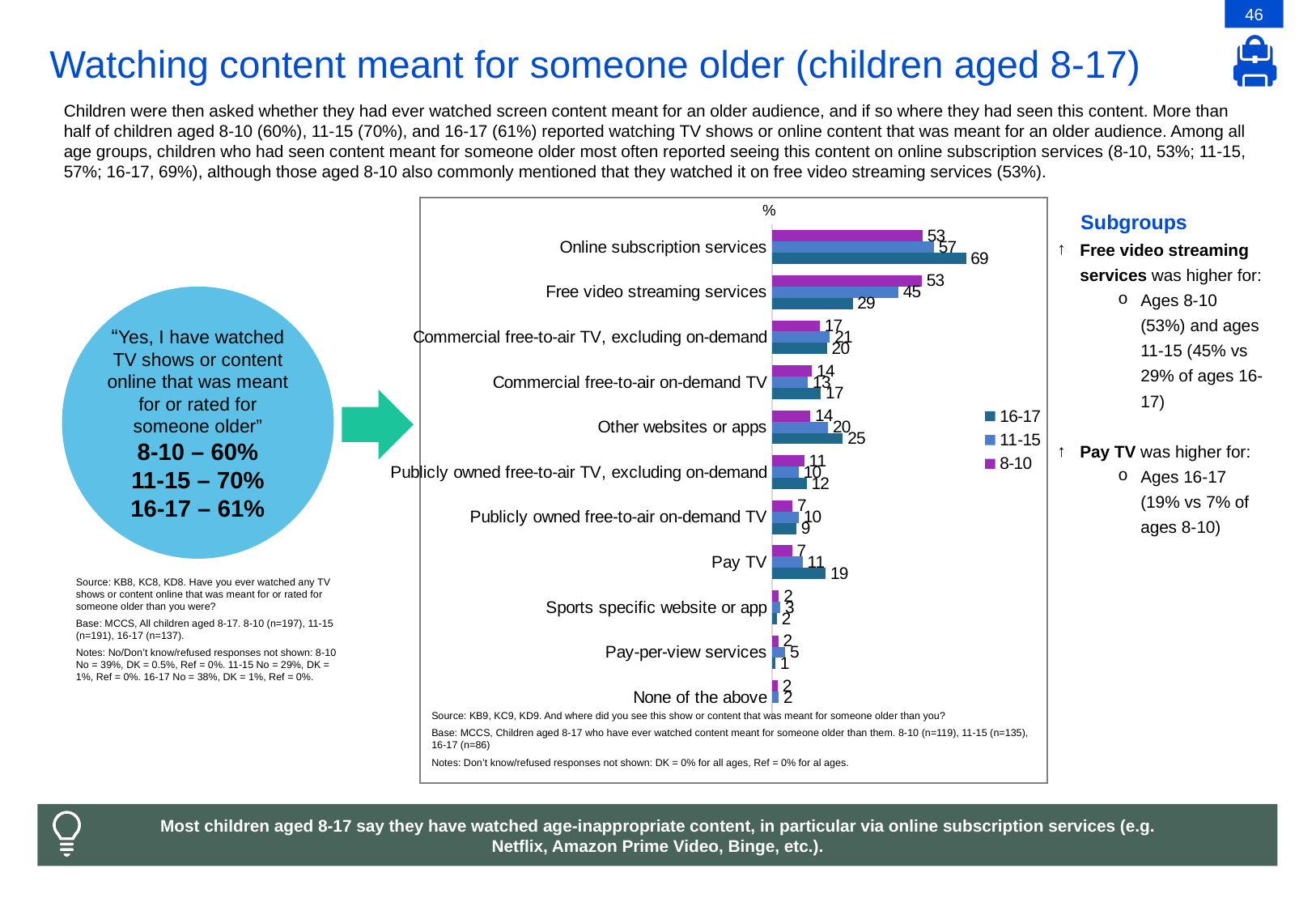
What is the value for ages 11-15 for Pay TV? 11 Which category has the highest value for ages 16-17? Online subscription services For Commercial free-to-air TV, excluding on-demand, which is larger: the value for ages 11-15 or ages 8-10? ages 11-15 How many series does the chart legend list? 3 For Pay-per-view services, which is larger: the value for ages 11-15 or ages 16-17? ages 11-15 What is the difference between the 16-17 and 8-10 values for Pay TV? 12 What is the value for ages 16-17 for Online subscription services? 69 Which age group is shown in purple in the chart legend? 8-10 What is the difference between the 8-10 and 16-17 values for Free video streaming services? 24 What is the value for ages 16-17 for Other websites or apps? 25 What is the value for ages 8-10 for Free video streaming services? 53 What kind of chart is shown on the slide? bar chart